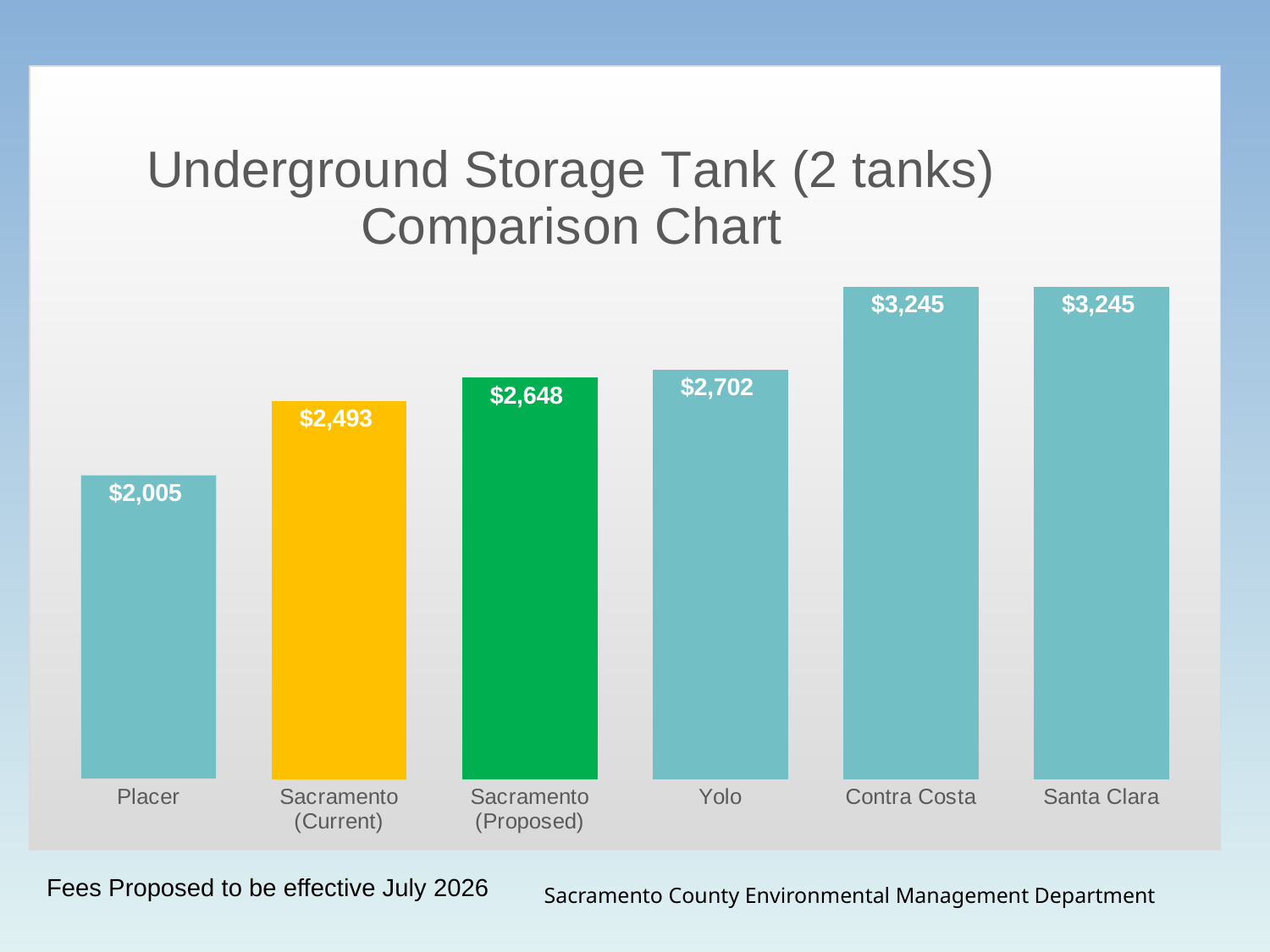
Do the values rise or fall from Placer to Santa Clara along the x axis? Rise What is the title of the chart? Underground Storage Tank (2 tanks) Comparison Chart How many categories are shown in the chart? 6 What is the value for Placer? $2,005 Which is larger, Yolo or Sacramento (Proposed)? Yolo What is the difference between Sacramento (Proposed) and Sacramento (Current)? $155 Which category has the lowest value? Placer What kind of chart is this? Bar chart What is the value for Sacramento (Current)? $2,493 What is the difference between Contra Costa and Placer? $1,240 What is the value for Sacramento (Proposed)? $2,648 What is the value for Yolo? $2,702